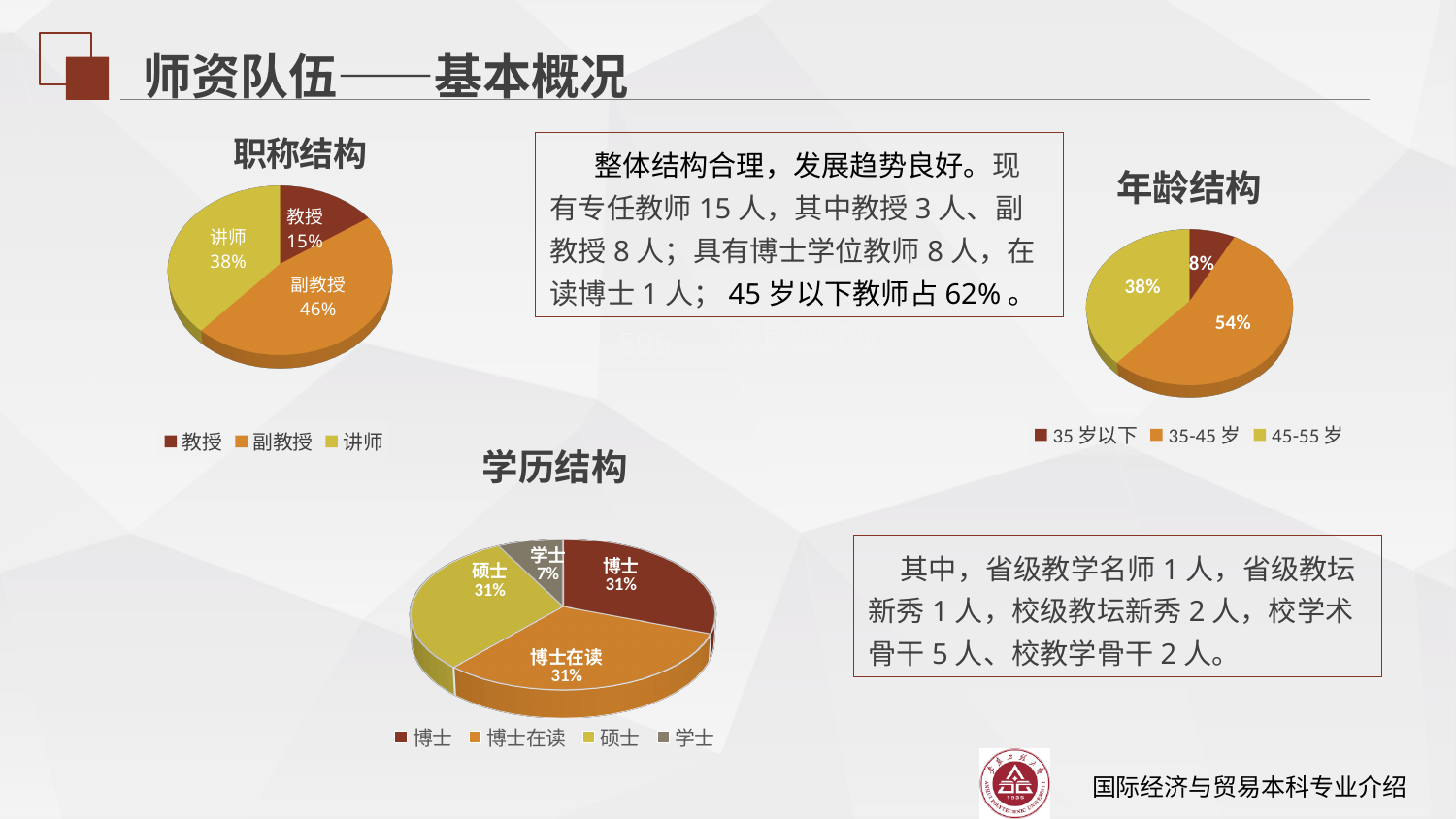
In the 学历结构 chart, what percentage is shown for 学士? 7% In the 年龄结构 chart, which age group has the smallest share? 35 岁以下 In the 职称结构 chart, what percentage is shown for 副教授? 46% In the 学历结构 chart, what percentage is shown for 博士在读? 31% In the 职称结构 chart, what percentage is shown for 教授? 15% In the 年龄结构 chart, what percentage is shown for the 35-45 岁 slice? 54% In the 年龄结构 chart, which is larger, the 35-45 岁 slice or the 45-55 岁 slice? 35-45 岁 In the 职称结构 chart, which category has the largest share? 副教授 In the 学历结构 chart, how many categories does the legend list? 4 In the 年龄结构 chart, how many categories does the legend list? 3 In the 职称结构 chart, what is the difference in percentage points between 讲师 and 教授? 23 What kind of chart is the 学历结构 chart? Pie chart